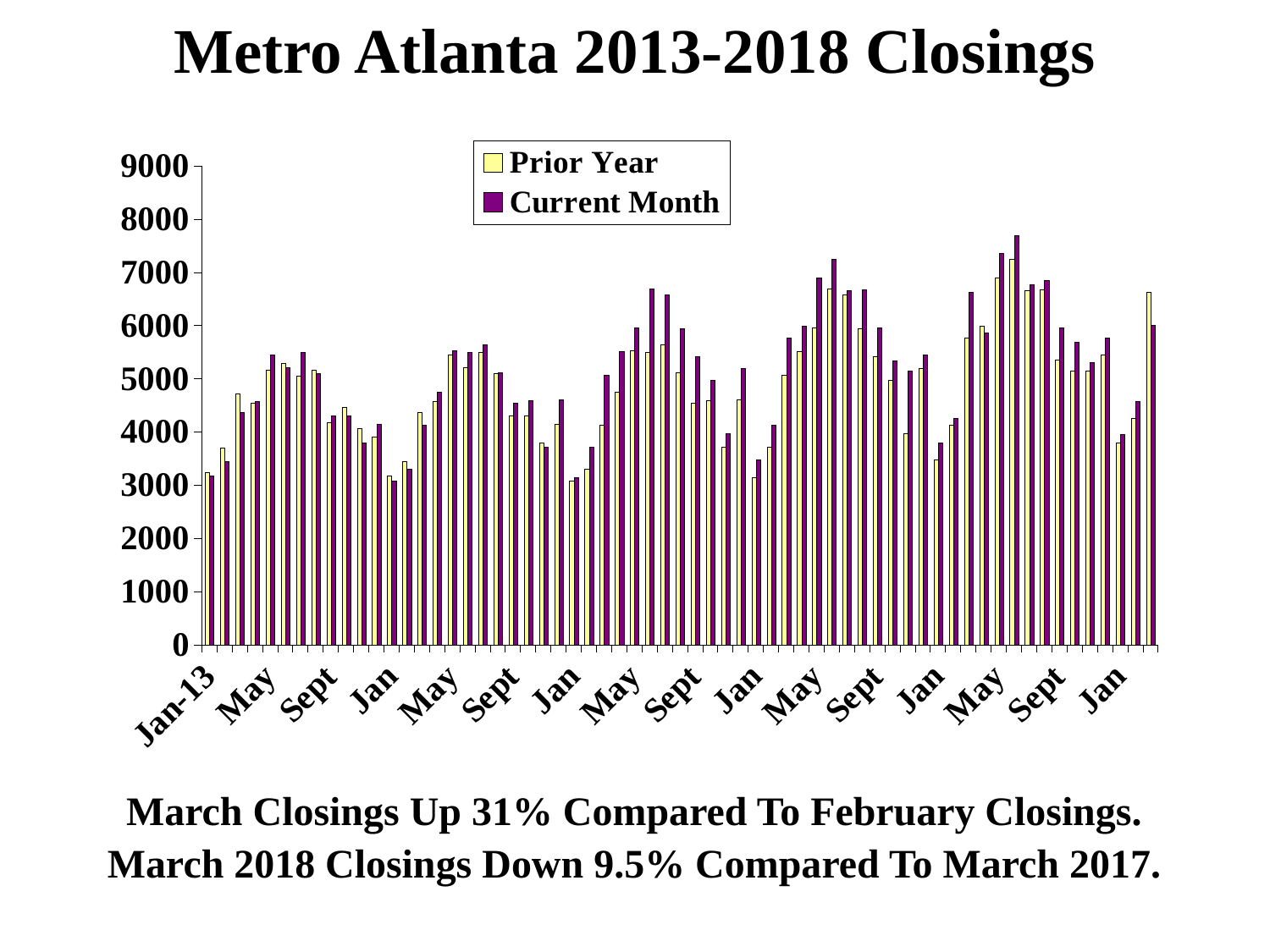
At the first May shown (May 2013), which series has the larger value, Prior Year or Current Month? Current Month What kind of chart is shown on the slide? bar chart Is the Prior Year value for Jan-13 greater or less than 3000? greater Which series is shown in purple? Current Month What is the title of the chart? Metro Atlanta 2013-2018 Closings Is the highest Current Month bar on the chart greater or less than 7000? greater Is the Current Month value for the first May shown (May 2013) greater or less than 5000? greater How many series does the legend list? 2 Do the Current Month values generally rise or fall from Jan-13 through 2017? rise